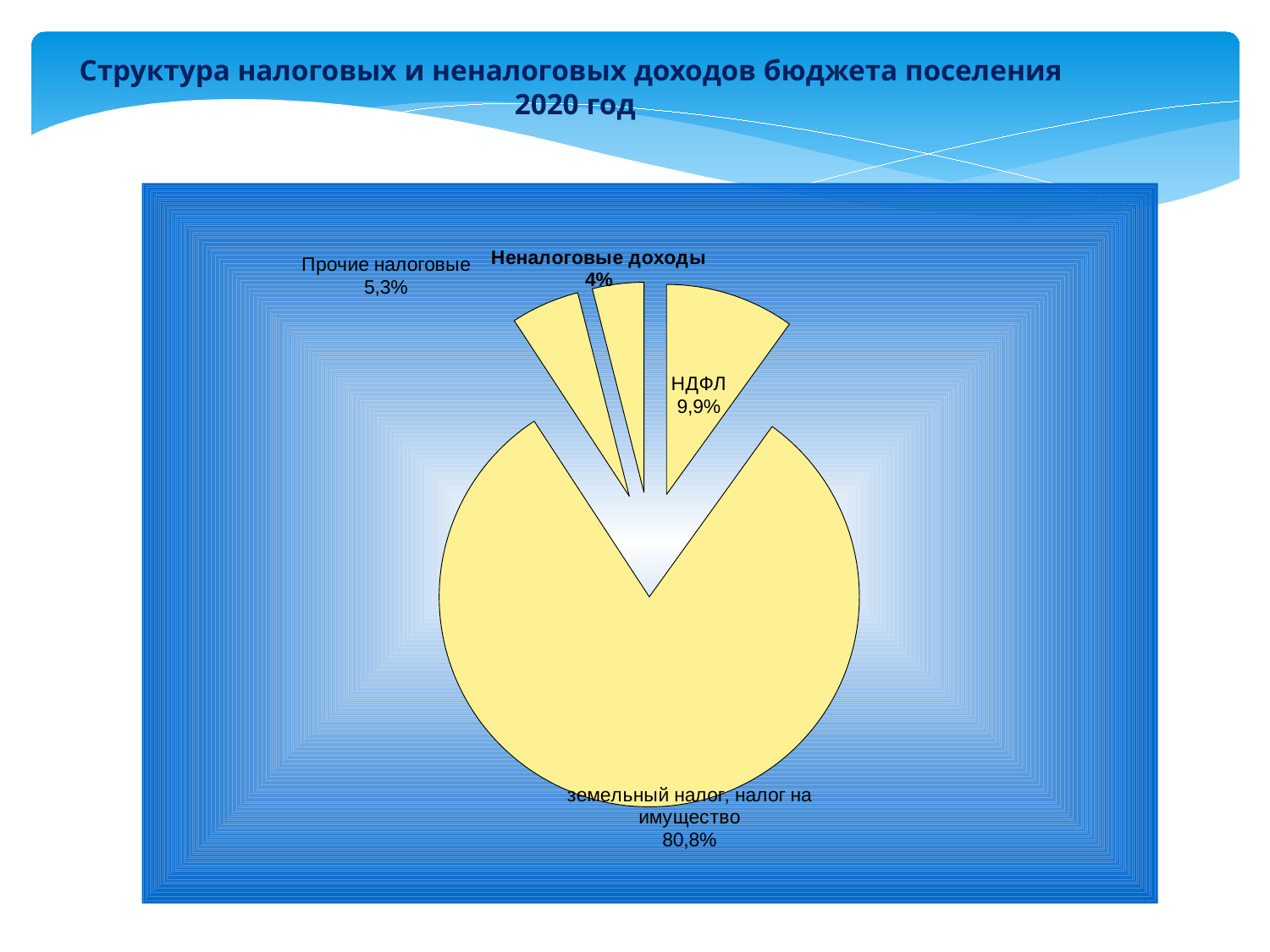
Which is larger, the share for НДФЛ or the share for "Прочие налоговые"? НДФЛ What is the value shown for "Неналоговые доходы"? 4% Which category has the largest slice of the pie? земельный налог, налог на имущество What kind of chart is shown on the slide? pie chart What is the difference between the share for "Прочие налоговые" and the share for "Неналоговые доходы"? 1,3% What is the title of the slide containing the chart? Структура налоговых и неналоговых доходов бюджета поселения 2020 год What is the value shown for "Прочие налоговые"? 5,3% What share of the pie does "земельный налог, налог на имущество" have? 80,8% What is the difference between the share for НДФЛ and the share for "Прочие налоговые"? 4,6% What is the value shown for НДФЛ? 9,9% How many slices does the pie chart have? 4 Which category has the smallest slice of the pie? Неналоговые доходы